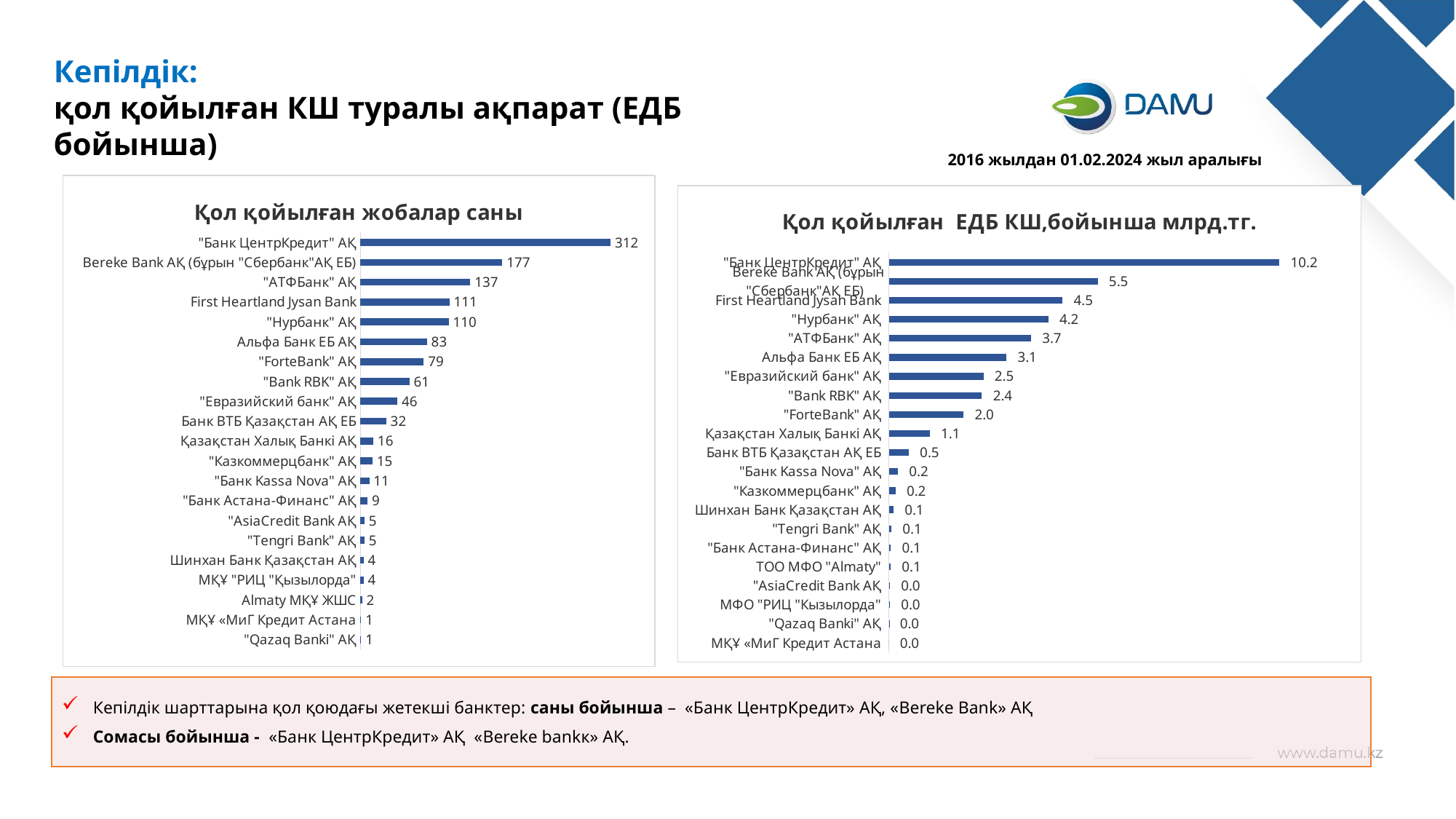
In the chart "Қол қойылған жобалар саны", which is larger: "ForteBank" АҚ or "Bank RBK" АҚ? "ForteBank" АҚ In the chart "Қол қойылған жобалар саны", what is the value for "АТФБанк" АҚ? 137 In the chart "Қол қойылған ЕДБ КШ,бойынша млрд.тг.", which category has the highest value? "Банк ЦентрКредит" АҚ What type of chart is "Қол қойылған жобалар саны"? Bar chart In the chart "Қол қойылған ЕДБ КШ,бойынша млрд.тг.", what is the difference between "Банк ЦентрКредит" АҚ and First Heartland Jysah Bank? 5.7 How many categories are shown in the chart "Қол қойылған жобалар саны"? 21 In the chart "Қол қойылған жобалар саны", what is the value for "Bank RBK" АҚ? 61 In the chart "Қол қойылған ЕДБ КШ,бойынша млрд.тг.", what is the value for "Нурбанк" АҚ? 4.2 In the chart "Қол қойылған ЕДБ КШ,бойынша млрд.тг.", which is larger: Қазақстан Халық Банкі АҚ or Банк ВТБ Қазақстан АҚ ЕБ? Қазақстан Халық Банкі АҚ In the chart "Қол қойылған жобалар саны", what is the difference between "Банк ЦентрКредит" АҚ and Bereke Bank АҚ (бұрын "Сбербанк"АҚ ЕБ)? 135 In the chart "Қол қойылған жобалар саны", which category has the highest value? "Банк ЦентрКредит" АҚ In the chart "Қол қойылған ЕДБ КШ,бойынша млрд.тг.", what is the value for "Евразийский банк" АҚ? 2.5